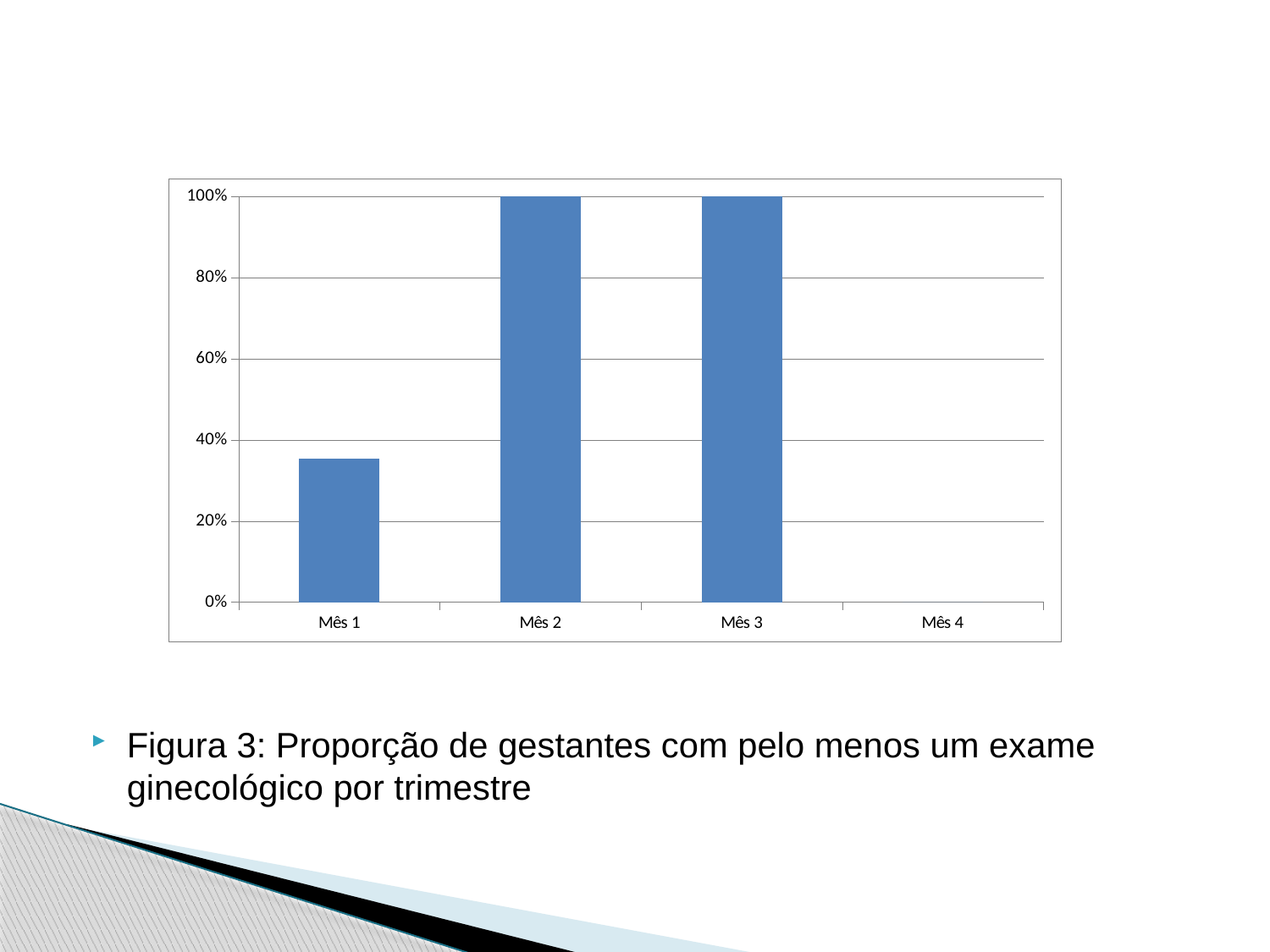
Does the value rise or fall from Mês 1 to Mês 2? rise Is the value for Mês 1 greater or less than 40%? less Which is larger, the value for Mês 1 or the value for Mês 2? Mês 2 How many categories are shown on the x axis of the chart? 4 What is the highest value shown on the y axis? 100% Is the value for Mês 1 greater or less than 20%? greater What is the value for Mês 3? 100% What is the value for Mês 2? 100% What kind of chart is shown on the slide? bar chart What is the figure number given in the caption below the chart? Figura 3 Which category on the x axis has no visible bar? Mês 4 Which months reach the highest value of 100%? Mês 2 and Mês 3